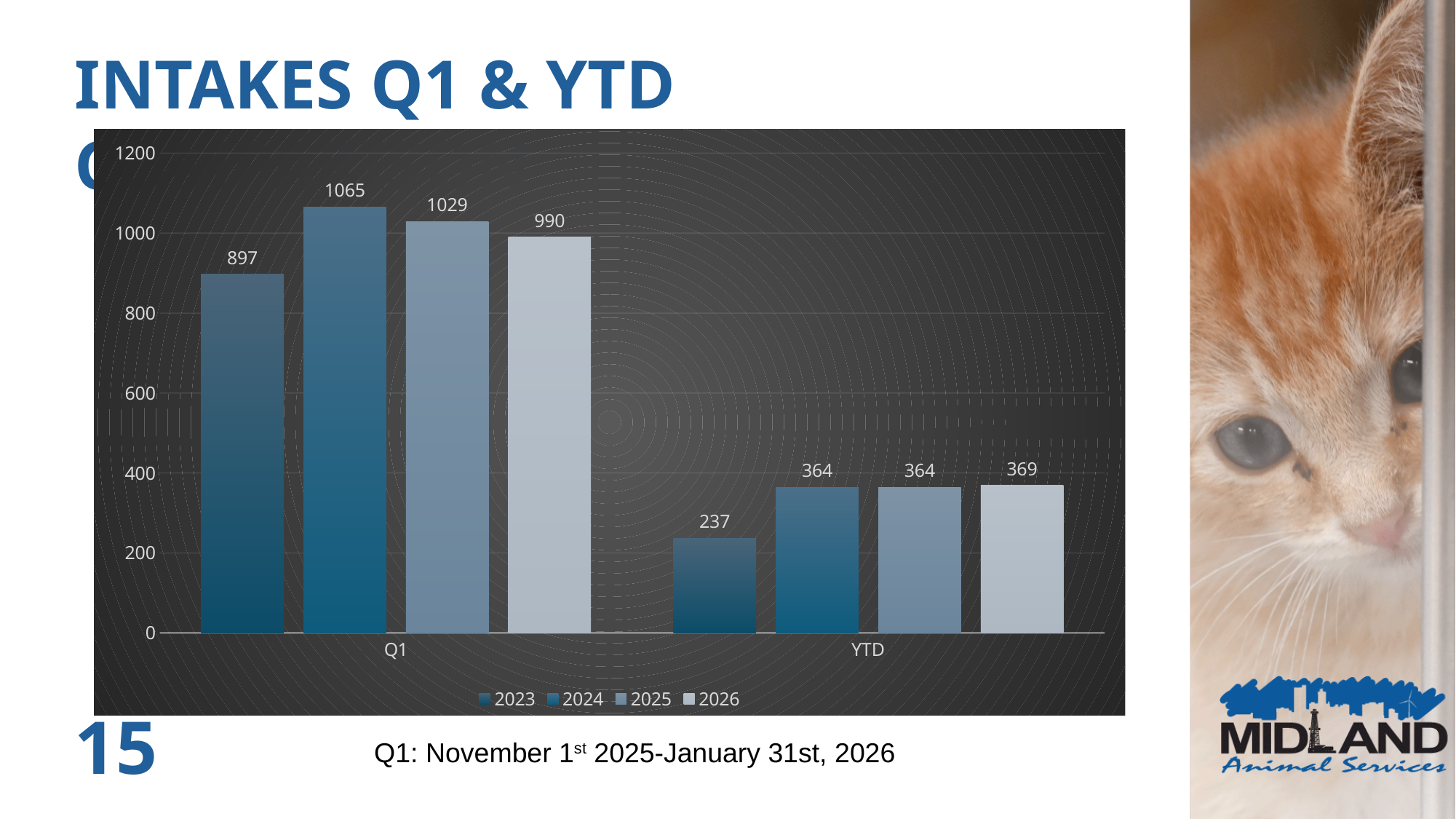
Is the Q1 value for 2025 greater or less than 1000? greater Which year has the lowest YTD intake value? 2023 What is the difference between the Q1 values for 2024 and 2025? 36 What is the Q1 intake value for 2024? 1065 What is the Q1 intake value for 2026? 990 Which is larger, the Q1 value for 2023 or the Q1 value for 2026? 2026 How many categories are shown on the x axis? 2 What is the difference between the YTD values for 2026 and 2023? 132 Which year has the highest Q1 intake value? 2024 What is the YTD intake value for 2023? 237 What kind of chart is shown on the slide? bar chart How many series does the legend list? 4